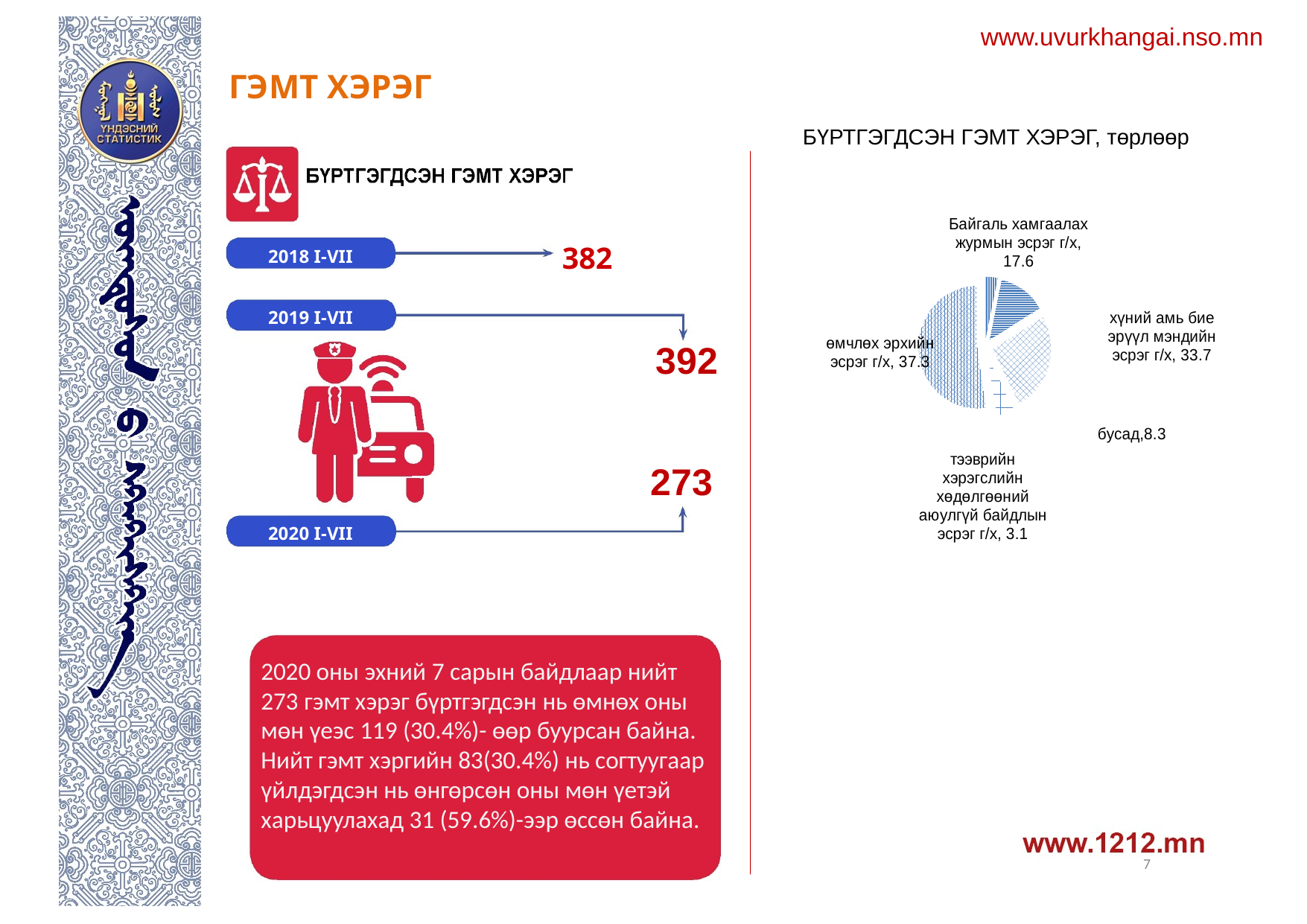
In the pie chart, what is the value for 'Байгаль хамгаалах журмын эсрэг г/х'? 17.6 In the pie chart, what is the difference between the values for 'өмчлөх эрхийн эсрэг г/х' and 'хүний амь бие эрүүл мэндийн эсрэг г/х'? 3.6 In the pie chart, what is the value for 'тээврийн хэрэгслийн хөдөлгөөний аюулгүй байдлын эсрэг г/х'? 3.1 What is the title of the pie chart on the right side of the slide? БҮРТГЭГДСЭН ГЭМТ ХЭРЭГ, төрлөөр What kind of chart is shown under the title 'БҮРТГЭГДСЭН ГЭМТ ХЭРЭГ, төрлөөр'? pie chart In the pie chart, what is the value for 'хүний амь бие эрүүл мэндийн эсрэг г/х'? 33.7 In the pie chart, what is the value for 'өмчлөх эрхийн эсрэг г/х'? 37.3 Which category has the largest slice in the pie chart? өмчлөх эрхийн эсрэг г/х In the pie chart, what is the value for 'бусад'? 8.3 How many slices does the pie chart have? 5